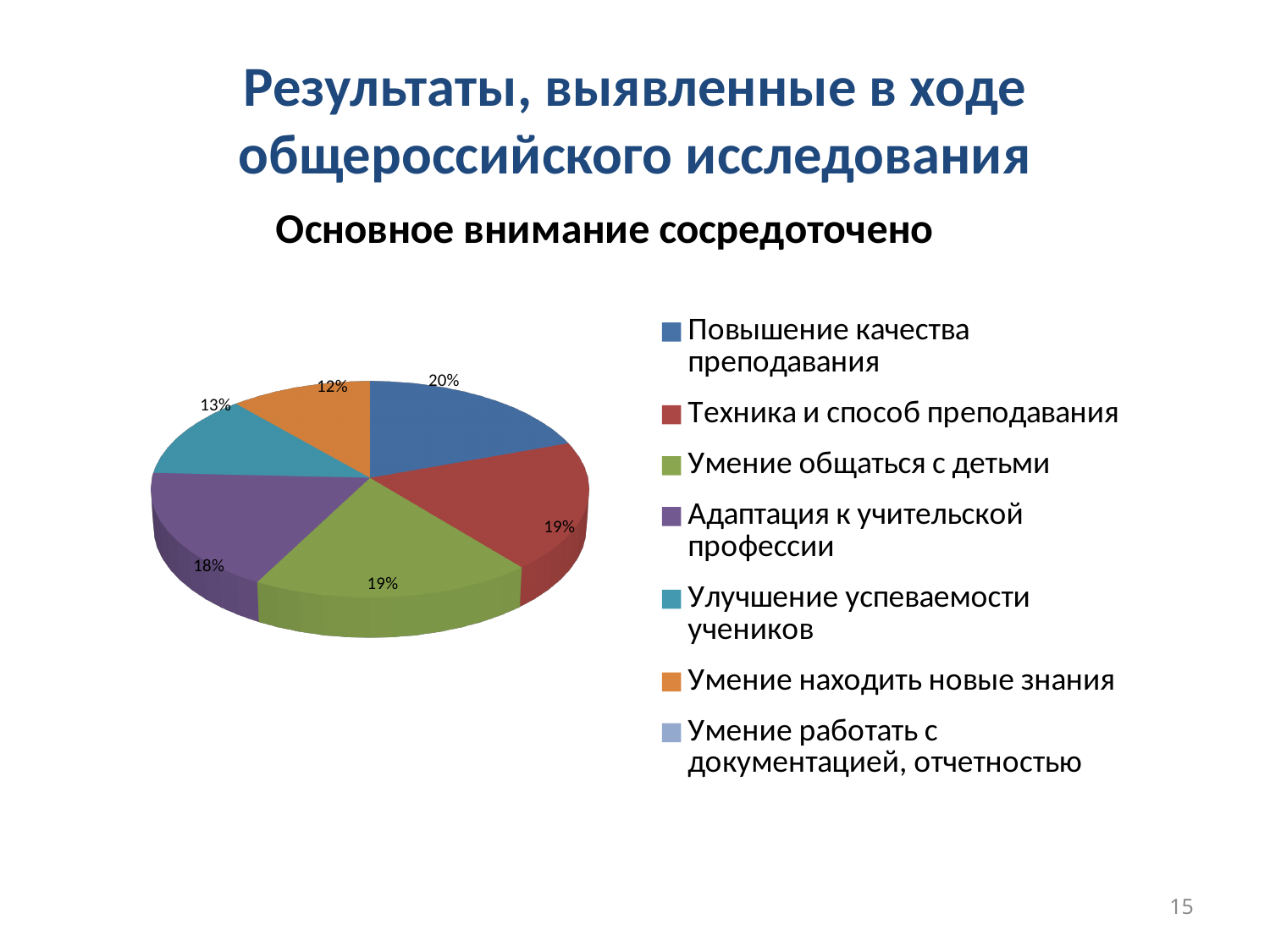
Which category has the largest slice of the pie? Повышение качества преподавания What colour represents "Умение общаться с детьми" in the chart? Green What share of the pie does "Повышение качества преподавания" hold? 20% What percentage is shown for "Адаптация к учительской профессии"? 18% What percentage is shown for "Техника и способ преподавания"? 19% How many entries does the legend list? 7 Which labelled slice of the pie is the smallest? Умение находить новые знания Which is larger: the share for "Улучшение успеваемости учеников" or for "Умение находить новые знания"? Улучшение успеваемости учеников What kind of chart is shown on the slide? Pie chart What percentage is shown for "Умение находить новые знания"? 12% What percentage is shown for "Улучшение успеваемости учеников"? 13% What is the difference in percentage points between "Повышение качества преподавания" and "Умение находить новые знания"? 8 percentage points